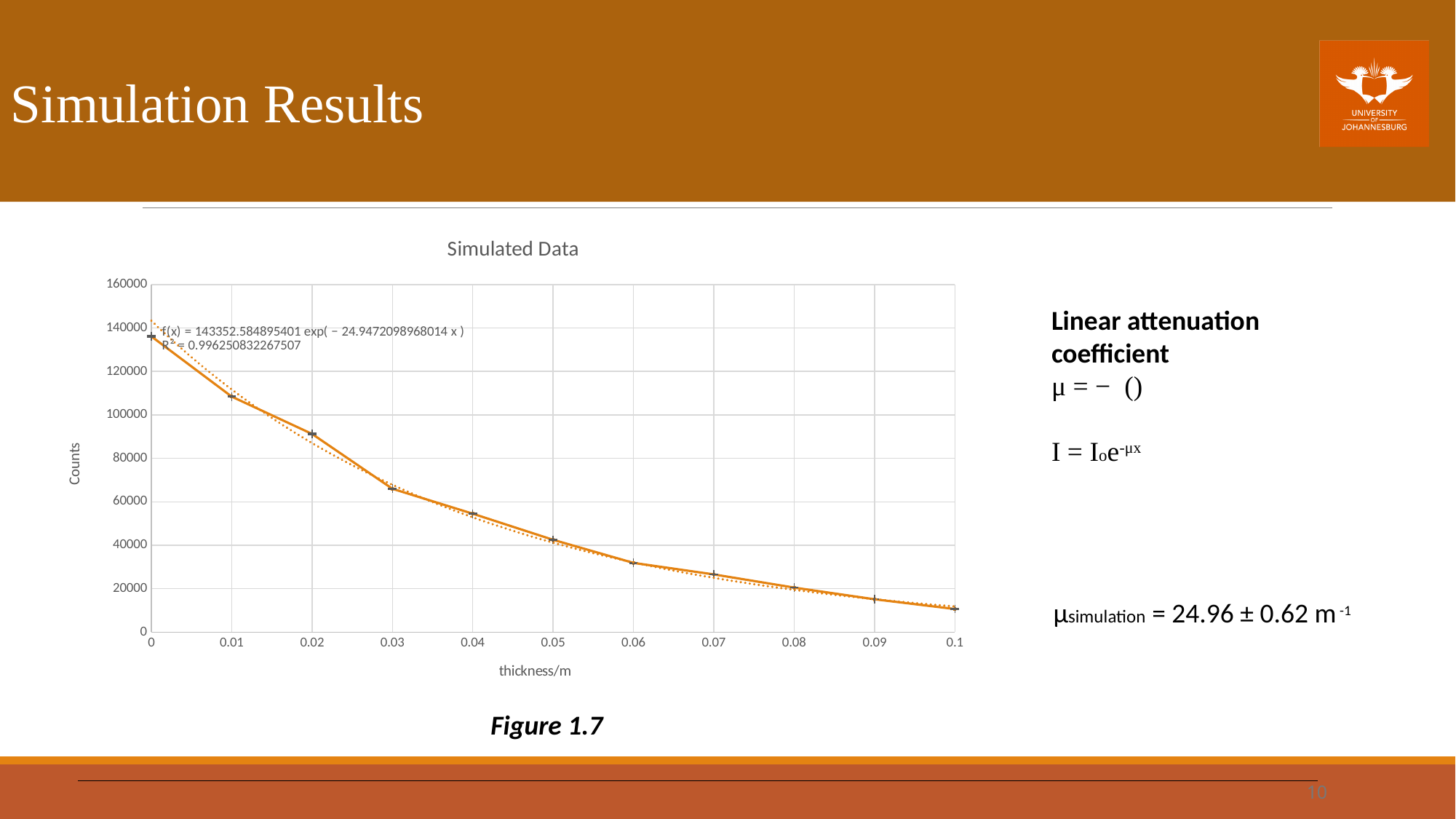
What kind of chart is shown on the slide? line chart What is the label of the x axis of the chart? thickness/m How many data points are plotted on the chart? 11 Do the counts rise or fall as thickness increases along the x axis? fall At which thickness is the count highest? 0 At which thickness is the count lowest? 0.1 Is the count at thickness 0.1 greater or less than 20000? less Is the count at thickness 0 greater or less than 120000? greater Is the count at thickness 0.02 greater or less than 100000? less What is the title of the chart? Simulated Data Which has the larger count, thickness 0.02 or thickness 0.05? 0.02